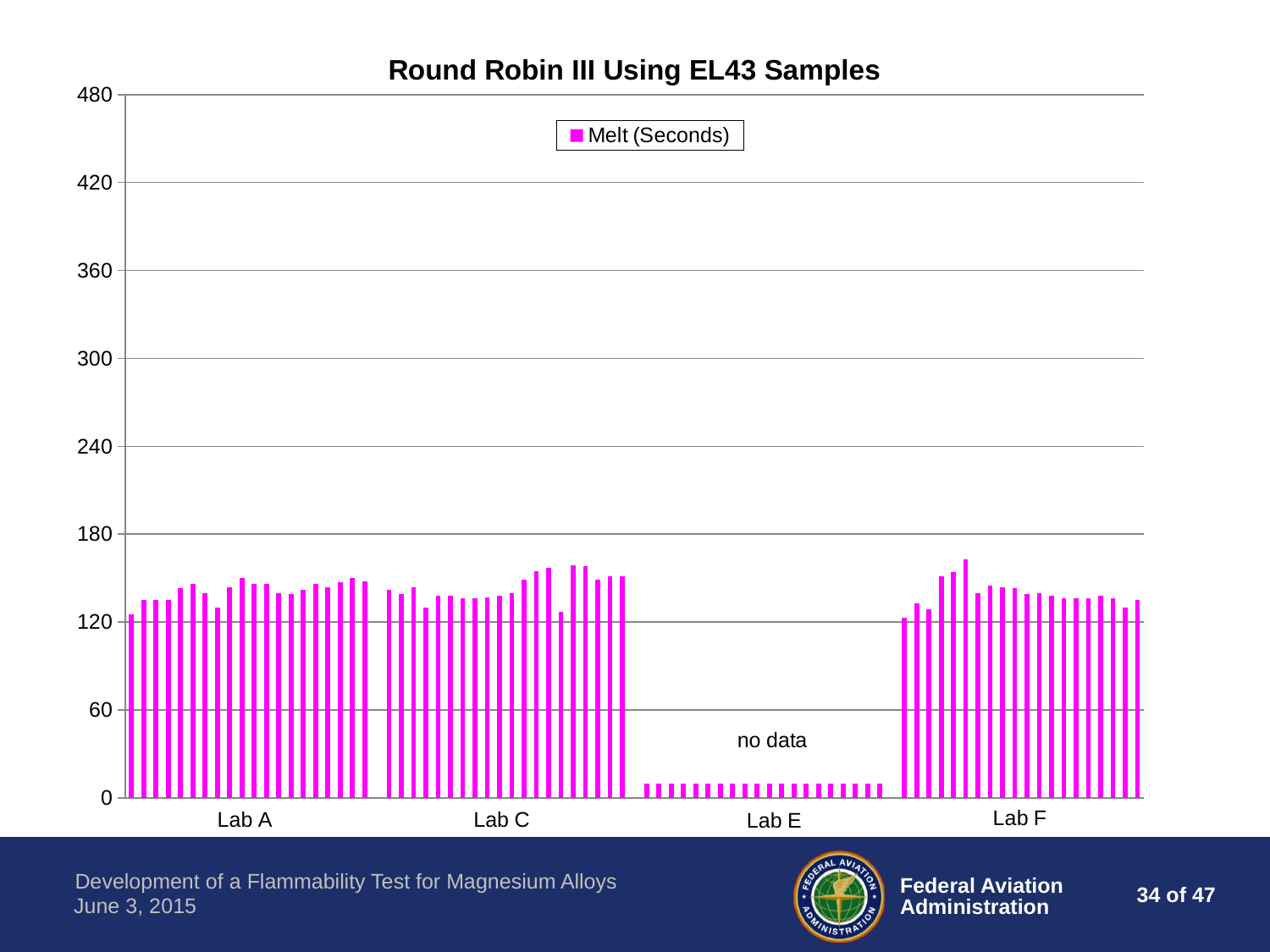
What series name is shown in the chart legend? Melt (Seconds) Are the Melt (Seconds) values for Lab C greater or less than 180? less Are the Melt (Seconds) values for Lab F greater or less than 240? less Is the tallest bar in Lab F higher or lower than the tallest bar in Lab A? higher Are the Melt (Seconds) values for Lab A greater or less than 120? greater Which lab group is marked as having no data in the chart? Lab E What kind of chart is shown on the slide? bar chart What is the highest value shown on the y axis of the chart? 480 How many series does the chart legend list? 1 What is the title of the chart? Round Robin III Using EL43 Samples How many lab groups are labelled along the x axis of the chart? 4 Which lab group contains the tallest bar in the chart? Lab F